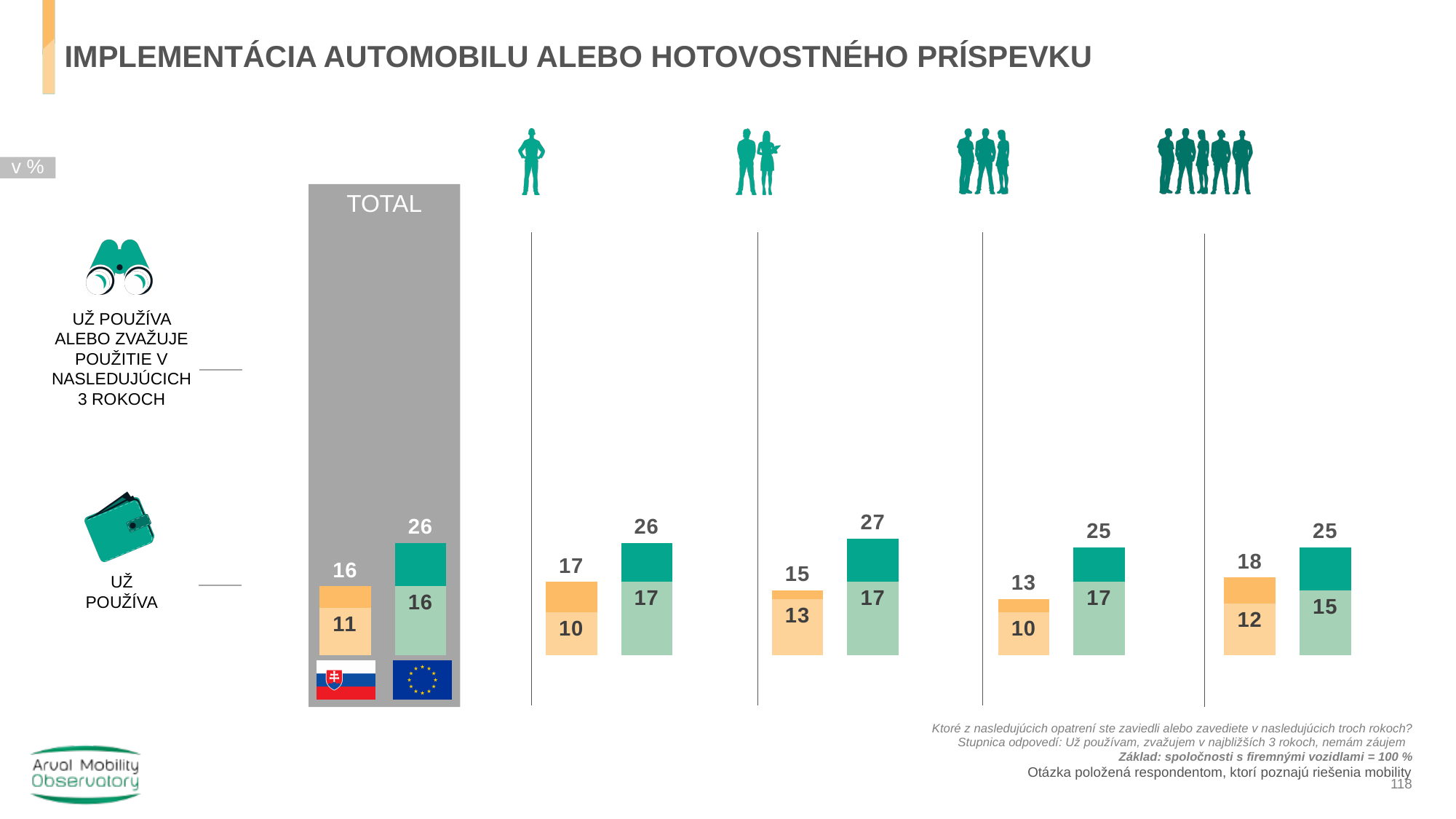
In the TOTAL column, what is the value for Slovakia (orange bar) for 'už používa alebo zvažuje použitie v nasledujúcich 3 rokoch'? 16 In the first company-size group to the right of TOTAL (single-person icon), what is the 'už používa' value for Slovakia? 10 What kind of chart is shown on the slide? Bar chart How many groups of bars are shown on the chart, including TOTAL? 5 In the TOTAL column, what is the 'už používa' value for Slovakia? 11 Across the four company-size groups, which group has the highest Slovakia (orange) value for 'už používa alebo zvažuje'? The fourth group (five-person icon), 18 In the second company-size group (two-person icon), which is larger: the Slovakia value or the EU value for 'už používa alebo zvažuje'? EU (27 vs 15) In the TOTAL column, what is the 'už používa' value for the EU? 16 In the TOTAL column, what is the difference between the EU value (26) and the Slovakia value (16) for 'už používa alebo zvažuje'? 10 In the TOTAL column, what is the value for the EU (green bar) for 'už používa alebo zvažuje použitie v nasledujúcich 3 rokoch'? 26 Across the four company-size groups, which group has the highest EU (green) value for 'už používa alebo zvažuje'? The second group (two-person icon), 27 Across the four company-size groups, which group has the lowest Slovakia (orange) value for 'už používa alebo zvažuje'? The third group (three-person icon), 13